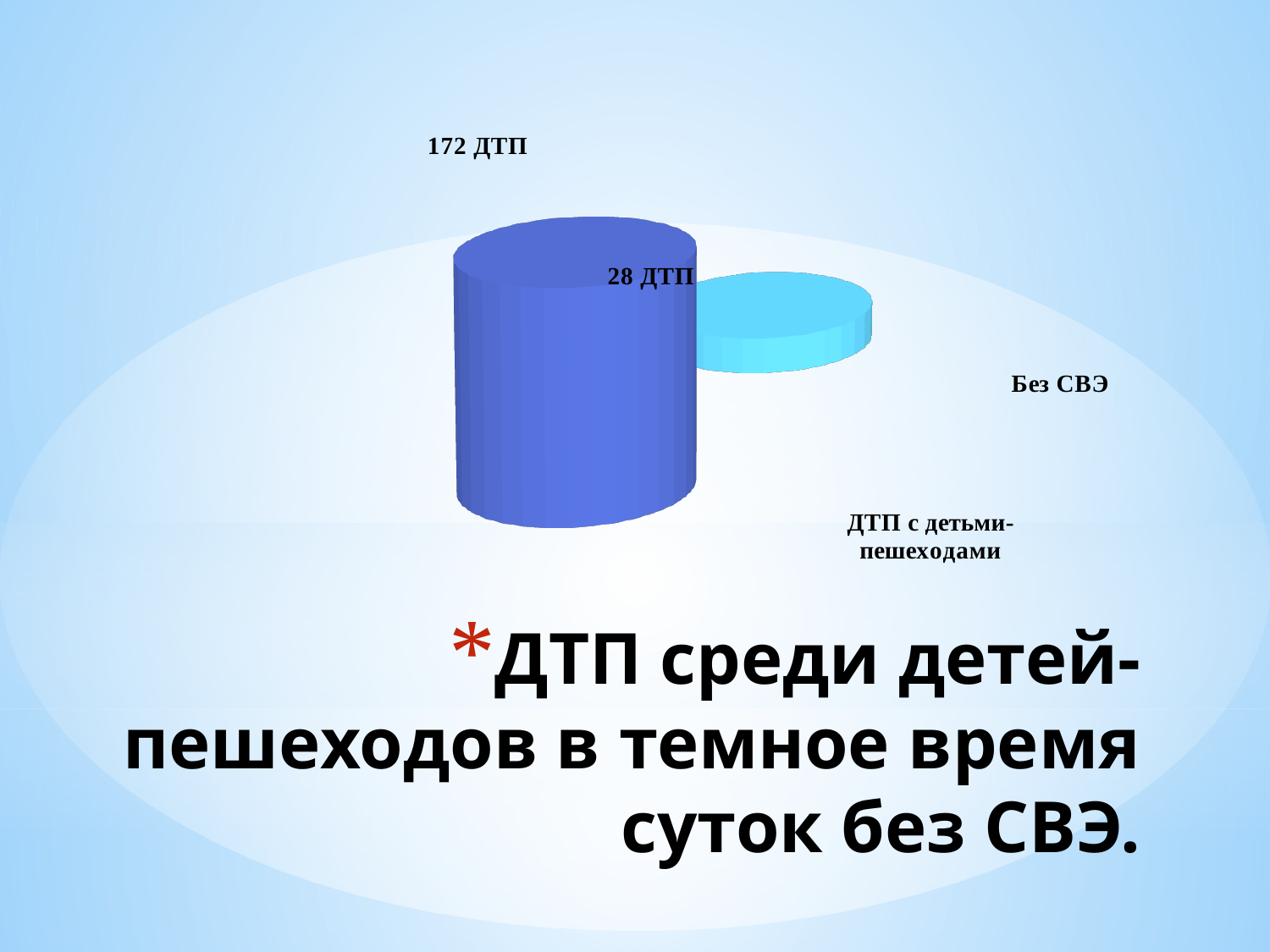
What value is labelled on the tall dark blue bar? 172 ДТП What colour is the bar labelled '172 ДТП'? dark blue What is the value for the category 'ДТП с детьми-пешеходами'? 172 ДТП What value is labelled on the short light blue bar? 28 ДТП What is the value for the category 'Без СВЭ'? 28 ДТП Which category has the highest value? ДТП с детьми-пешеходами Which category has the lowest value? Без СВЭ What is the difference between the two values shown on the chart? 144 What kind of chart is shown on the slide? bar chart How many bars does the chart show? 2 What colour is the bar labelled '28 ДТП'? light blue Which is larger: the value for 'ДТП с детьми-пешеходами' or the value for 'Без СВЭ'? ДТП с детьми-пешеходами